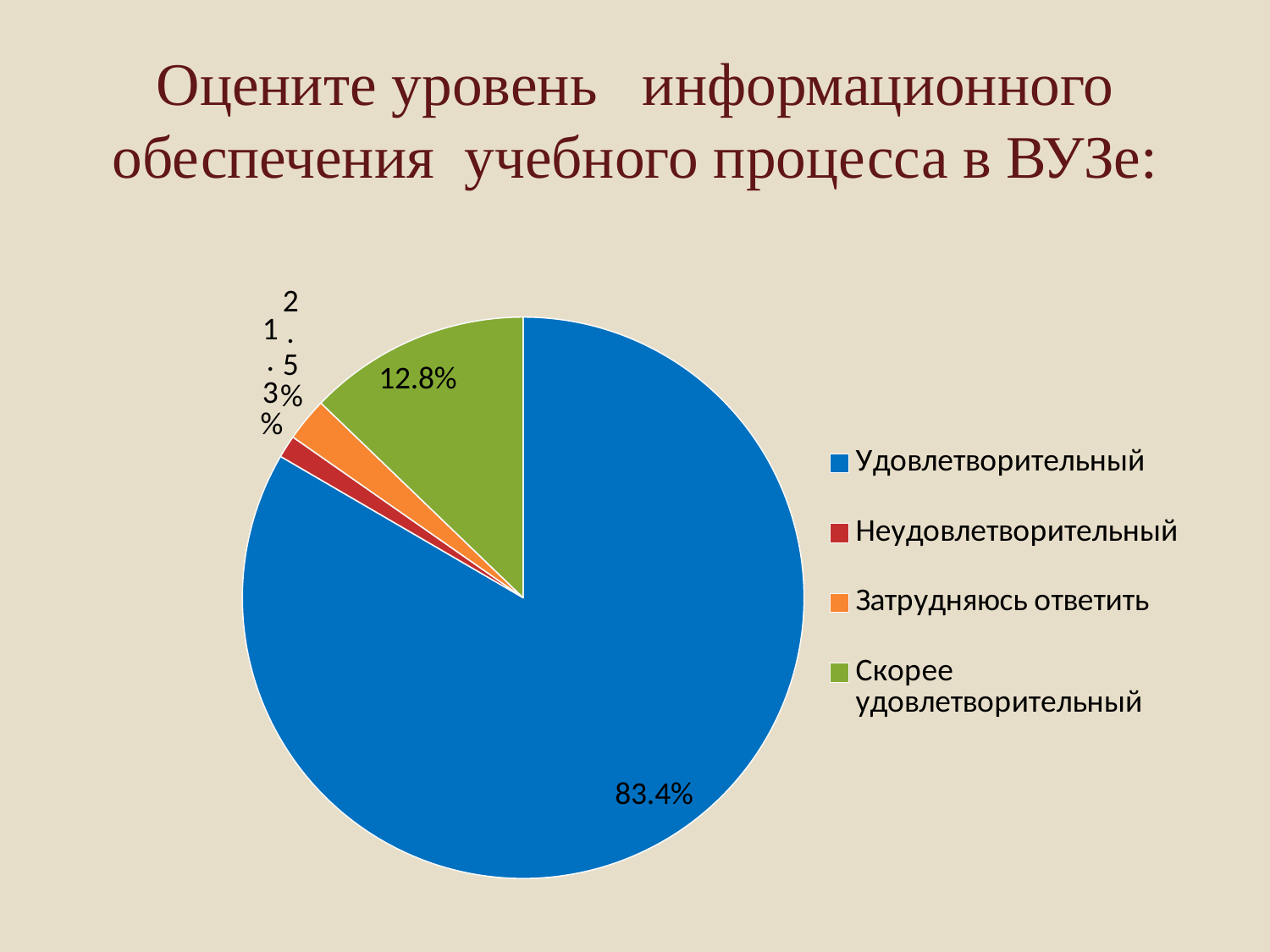
Which is larger, the slice for Затрудняюсь ответить or the slice for Неудовлетворительный? Затрудняюсь ответить What colour is the slice for Скорее удовлетворительный? green Which category has the smallest slice of the pie? Неудовлетворительный What is the difference between the shares for Удовлетворительный and Скорее удовлетворительный? 70.6% How many categories does the legend list? 4 How many slices does the pie chart have? 4 What share of the pie is labelled for Удовлетворительный? 83.4% What share of the pie is labelled for Скорее удовлетворительный? 12.8% What kind of chart is shown on the slide? pie chart Which category has the largest slice of the pie? Удовлетворительный What colour is the slice for Удовлетворительный? blue Which is larger, the slice for Скорее удовлетворительный or the slice for Затрудняюсь ответить? Скорее удовлетворительный